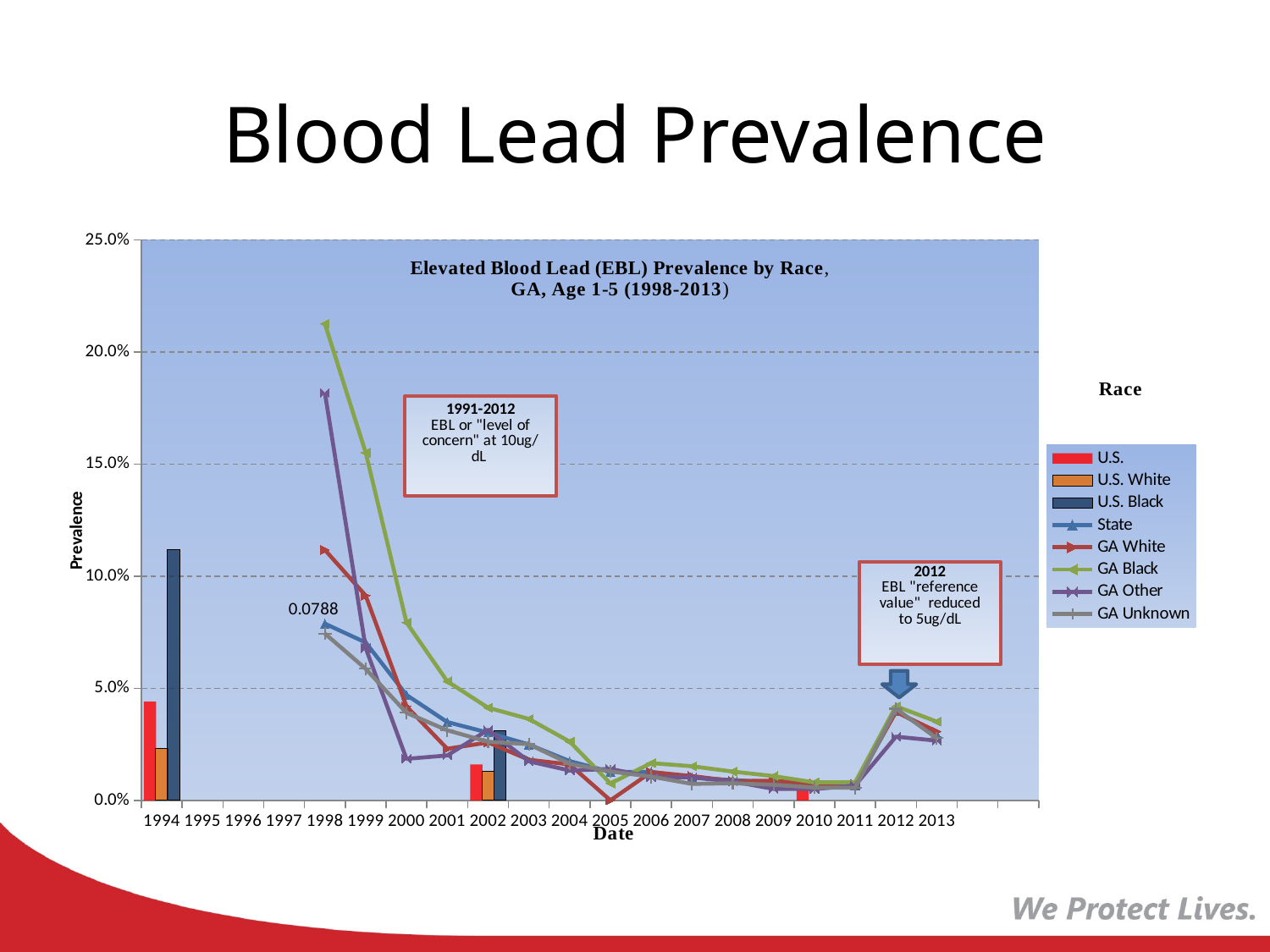
Is the value for GA Other in 1998 greater or less than 15.0%? greater Which series has the lowest value in 2005? GA White Which series has the highest value in 1998? GA Black In 1994, which bar is taller: U.S. Black or U.S. White? U.S. Black In 1998, which is larger: GA Black or GA White? GA Black Does the GA Black line rise or fall from 1998 to 2005? Fall Is the value for GA Black in 1998 greater or less than 20.0%? greater What is the title of the legend? Race What kind of chart is this? Combined bar and line chart Is the value for U.S. Black in 1994 greater or less than 10.0%? greater What value is printed as a data label on the State line in 1998? 0.0788 How many series does the legend list? 8